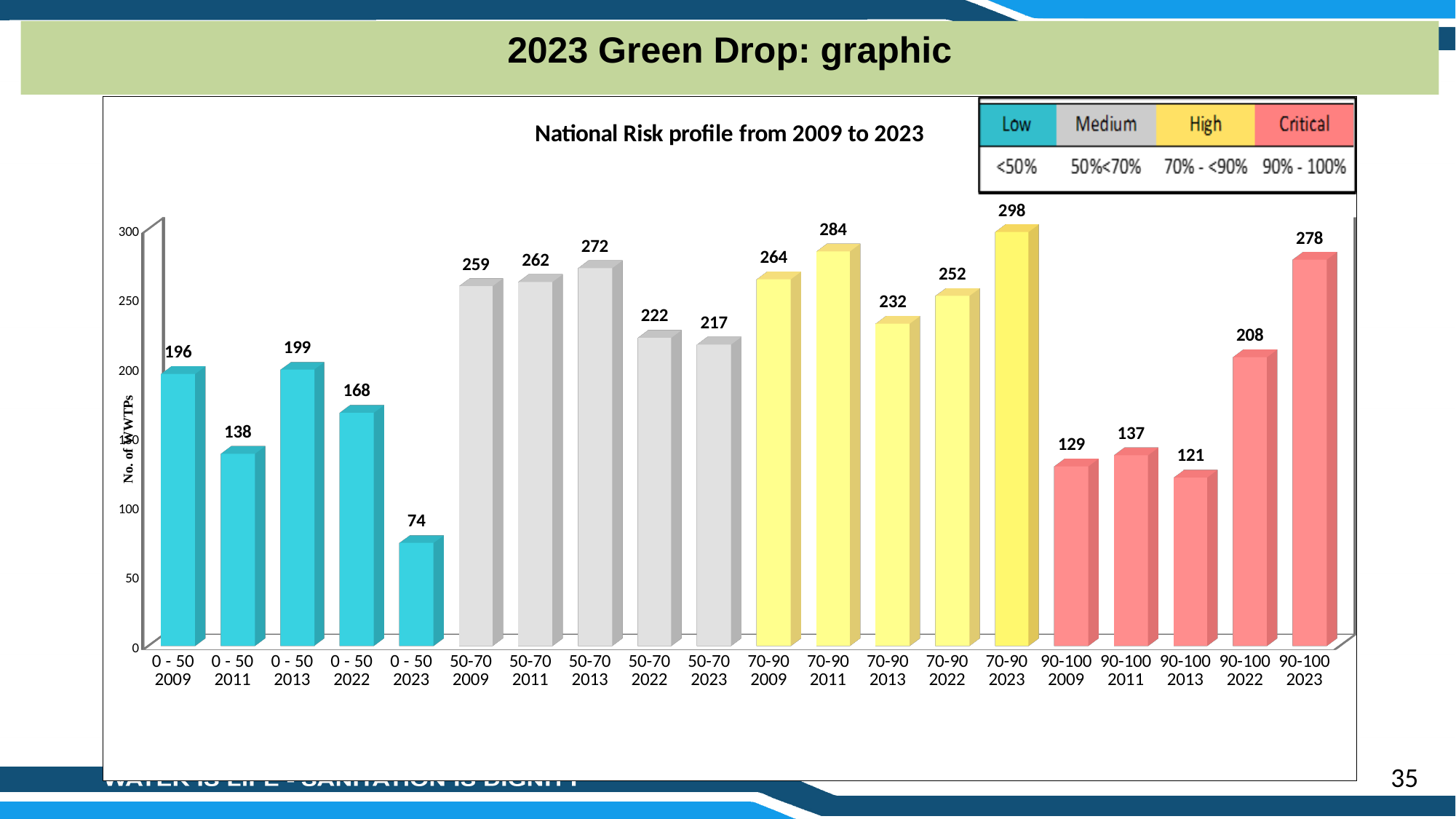
What kind of chart is shown on the slide? bar chart What is the value for 0 - 50 2023? 74 Which category has the lowest value? 0 - 50 2023 What is the value for 90-100 2022? 208 Is the value for 50-70 2022 greater or less than 200? greater What is the title of the chart? National Risk profile from 2009 to 2023 Which category has the highest value? 70-90 2023 Do the values for the 90-100 group rise or fall from 2013 to 2023? rise Which is larger, the value for 50-70 2013 or the value for 70-90 2011? 70-90 2011 How many bars are plotted in the chart? 20 What is the value for 70-90 2023? 298 What is the difference between the values for 90-100 2023 and 90-100 2013? 157